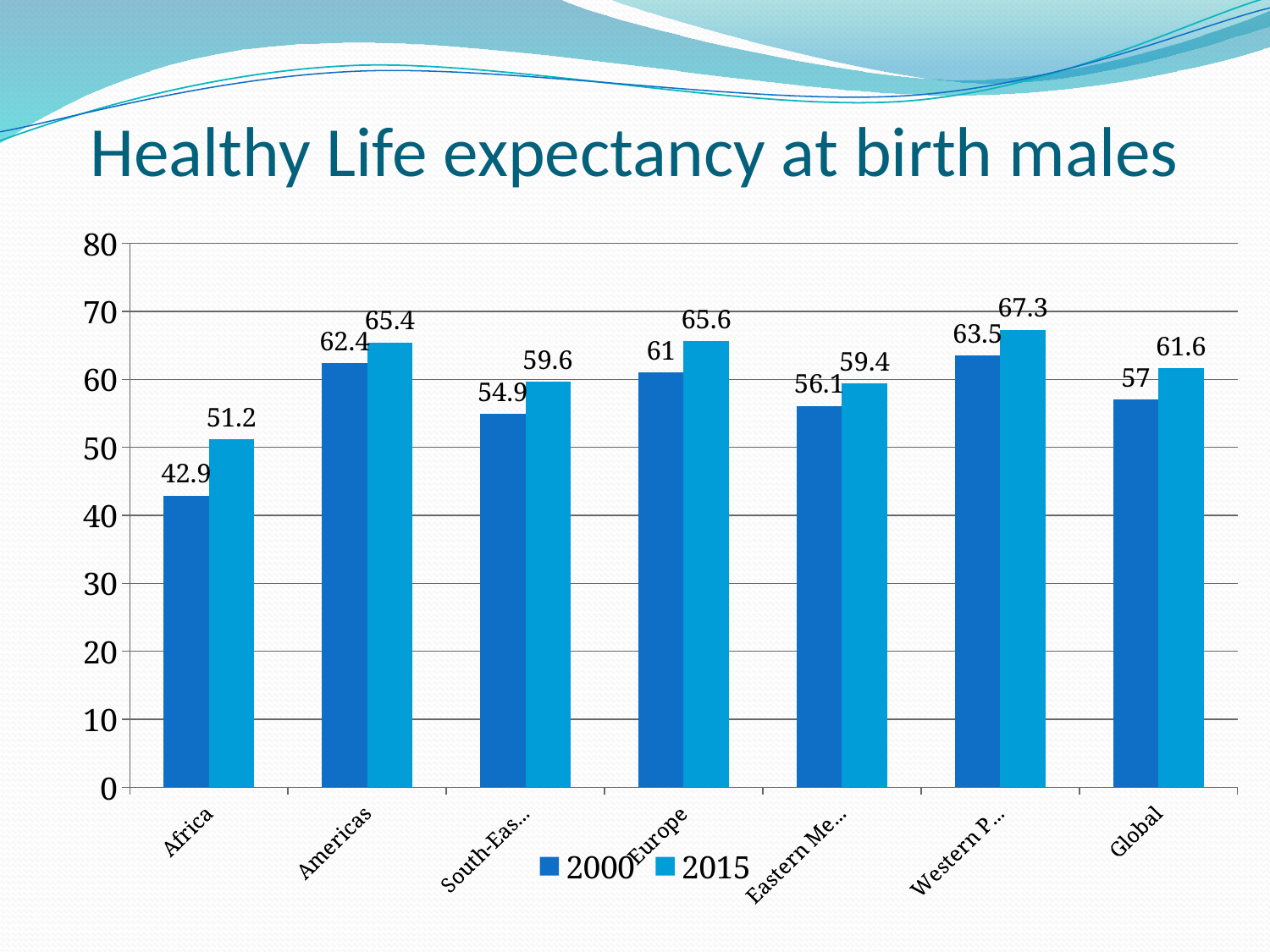
What is the 2000 value for Global? 57 What kind of chart is shown on the slide? Bar chart Which category has the lowest 2000 value? Africa By how much did the value for Africa increase from 2000 to 2015? 8.3 What is the 2000 value for Africa? 42.9 How many series does the legend list? 2 Which category has the lowest 2015 value? Africa How many categories are shown on the x axis? 7 What is the 2015 value for Europe? 65.6 Which is larger, the 2000 value for the Americas or the 2000 value for Europe? Americas What is the difference between the 2015 and 2000 values for Europe? 4.6 What is the 2015 value for the Americas? 65.4